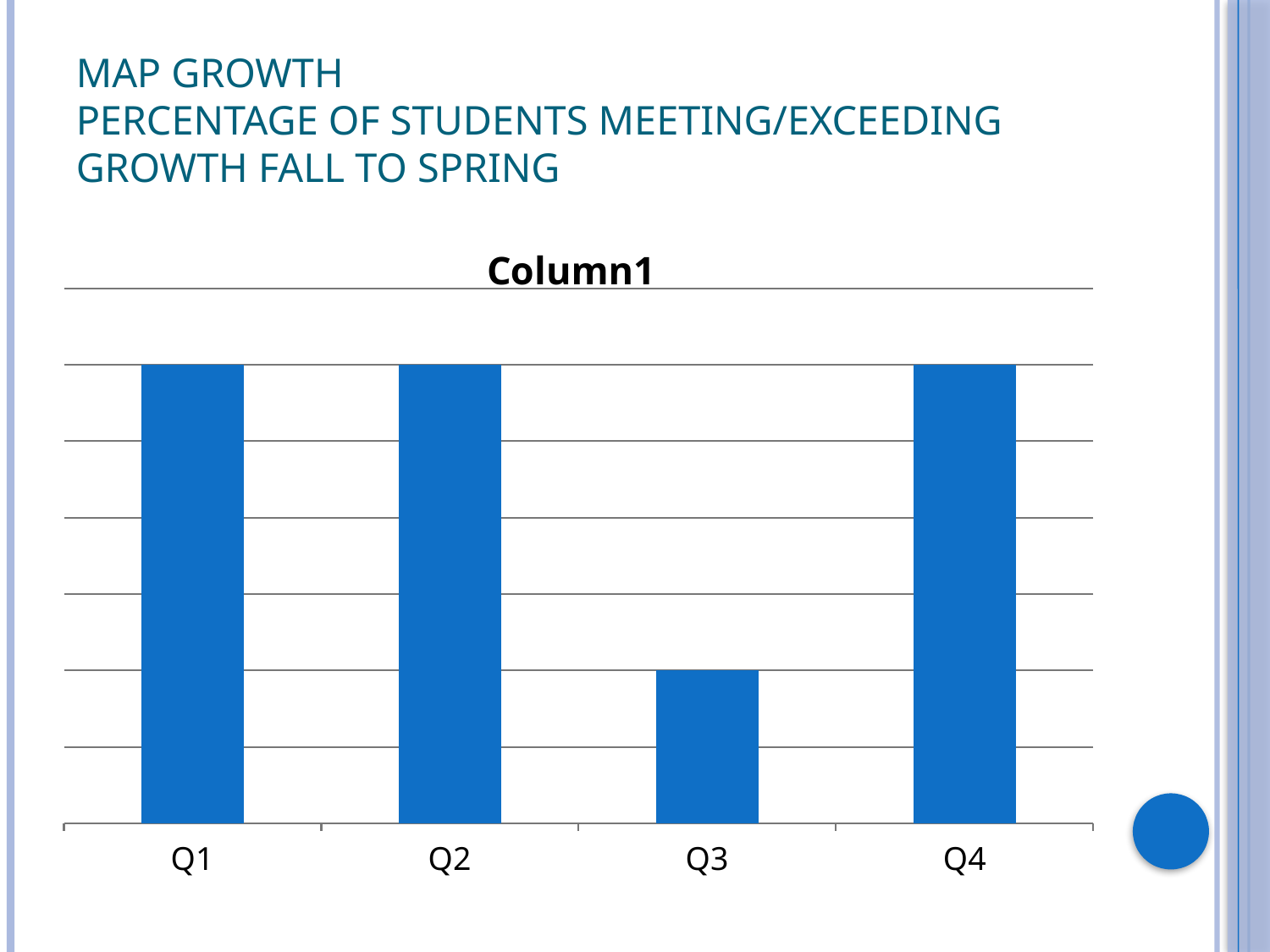
What is the title shown above the chart? Column1 What kind of chart is shown on the slide? bar chart How many categories are shown on the x axis of the chart? 4 Which is larger, the value for Q2 or the value for Q3? Q2 Which is larger, the value for Q1 or the value for Q3? Q1 What are the category labels on the x axis of the chart, from left to right? Q1, Q2, Q3, Q4 Which category has the lowest bar in the chart? Q3 Which is larger, the value for Q3 or the value for Q4? Q4